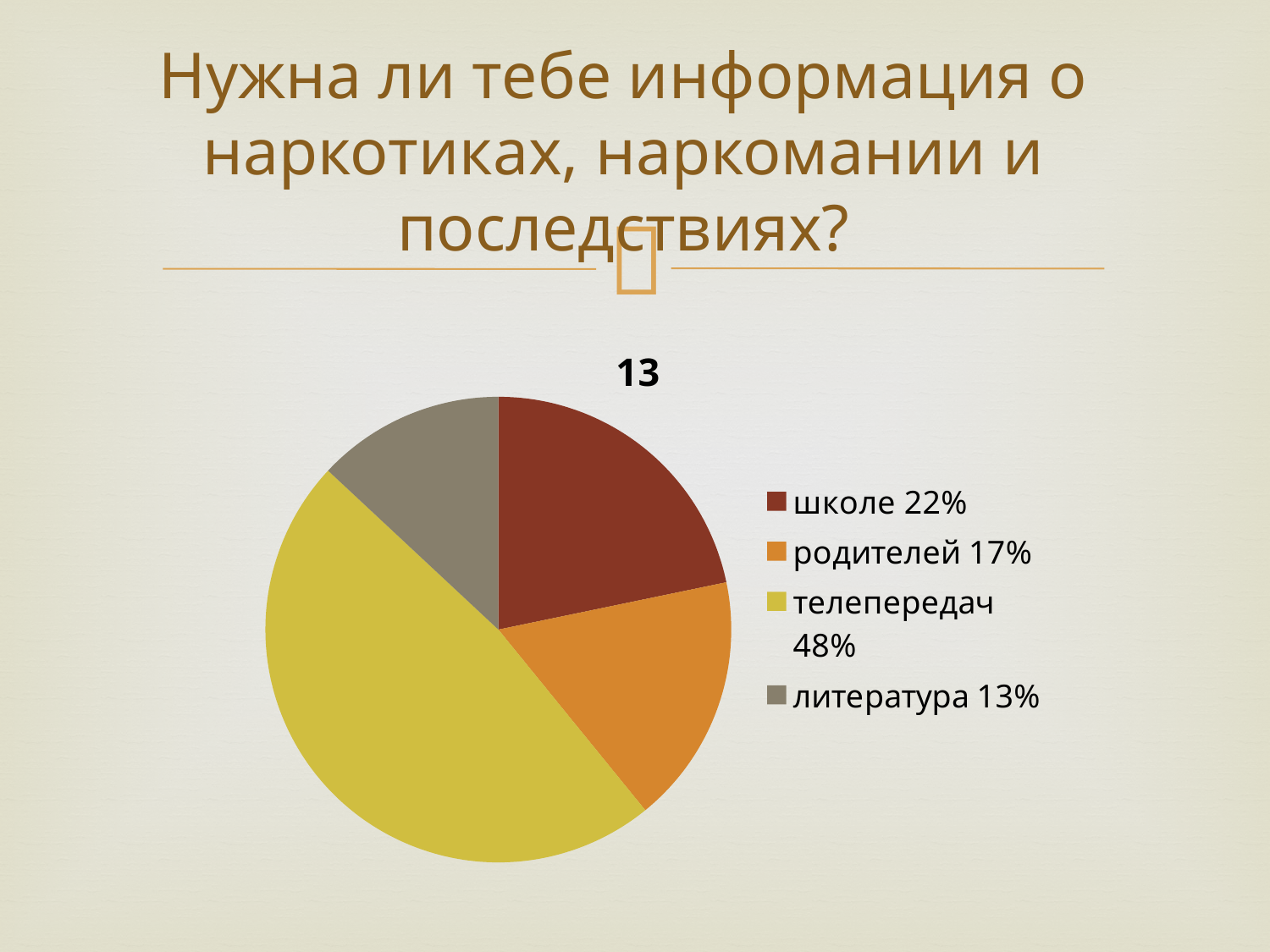
What colour is the slice for телепередач? yellow What kind of chart is shown on the slide? pie chart What is the title shown above the pie chart? 13 What percentage is shown for родителей in the legend? 17% What is the difference in percentage points between телепередач and школе? 26 What percentage is shown for телепередач in the legend? 48% Which is larger, the share for школе or the share for родителей? школе Which category has the smallest slice of the pie? литература Which category has the largest slice of the pie? телепередач What percentage is shown for литература in the legend? 13% What percentage is shown for школе in the legend? 22% How many slices does the pie chart have? 4